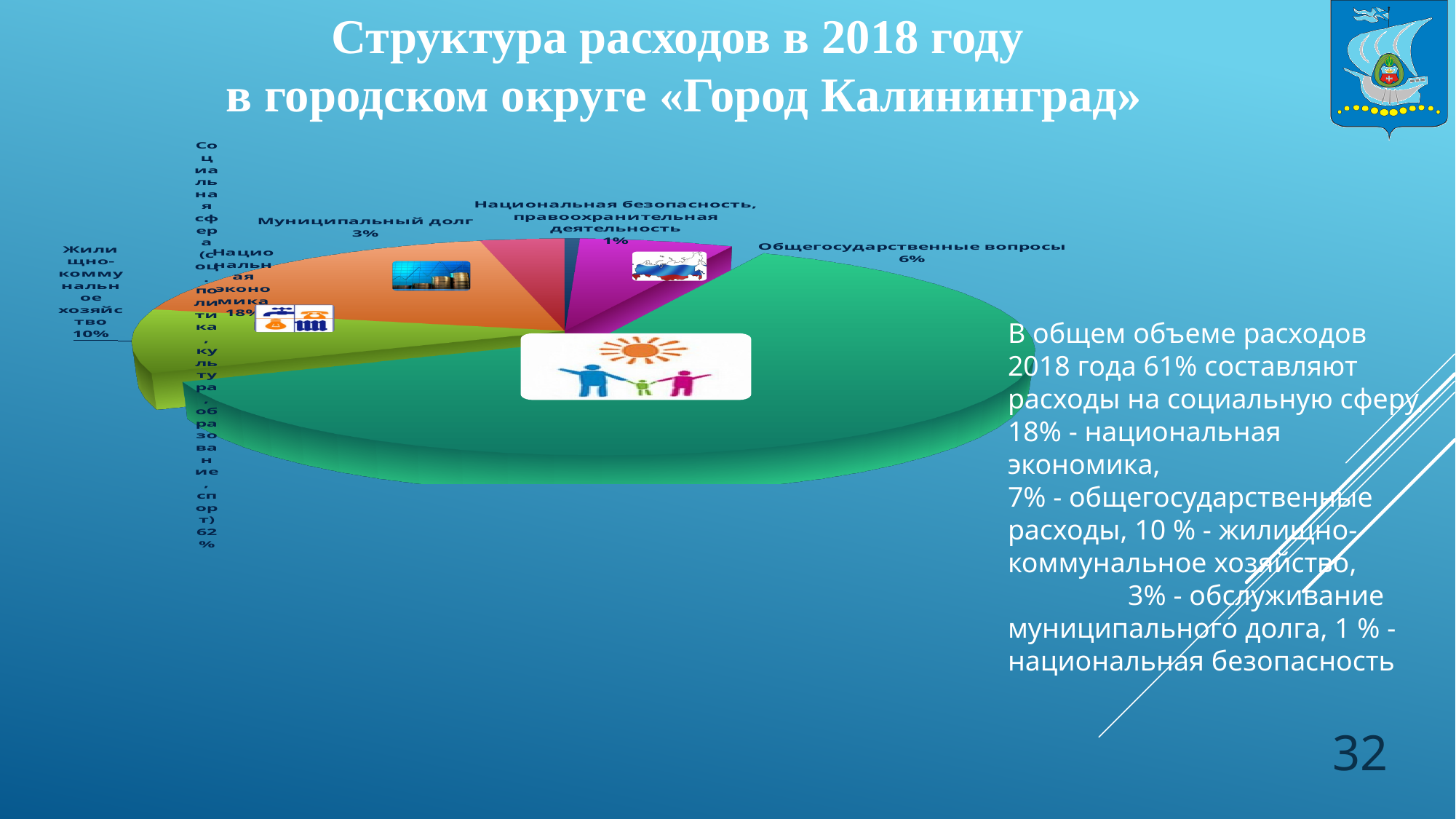
Which is larger, the slice for Общегосударственные вопросы or the slice for Муниципальный долг? Общегосударственные вопросы What percentage does the chart show for Общегосударственные вопросы? 6% What is the difference in percentage points between Национальная экономика and Жилищно-коммунальное хозяйство? 8 What is the title of the slide containing the chart? Структура расходов в 2018 году в городском округе «Город Калининград» How many slices does the pie chart have? 6 Which category has the smallest slice of the pie? Национальная безопасность, правоохранительная деятельность Which category has the largest slice of the pie? Социальная сфера What kind of chart is shown on the slide? Pie chart What percentage does the chart show for Национальная экономика? 18% What percentage does the chart show for Жилищно-коммунальное хозяйство? 10% What percentage does the chart show for Муниципальный долг? 3% What percentage does the chart show for Национальная безопасность, правоохранительная деятельность? 1%